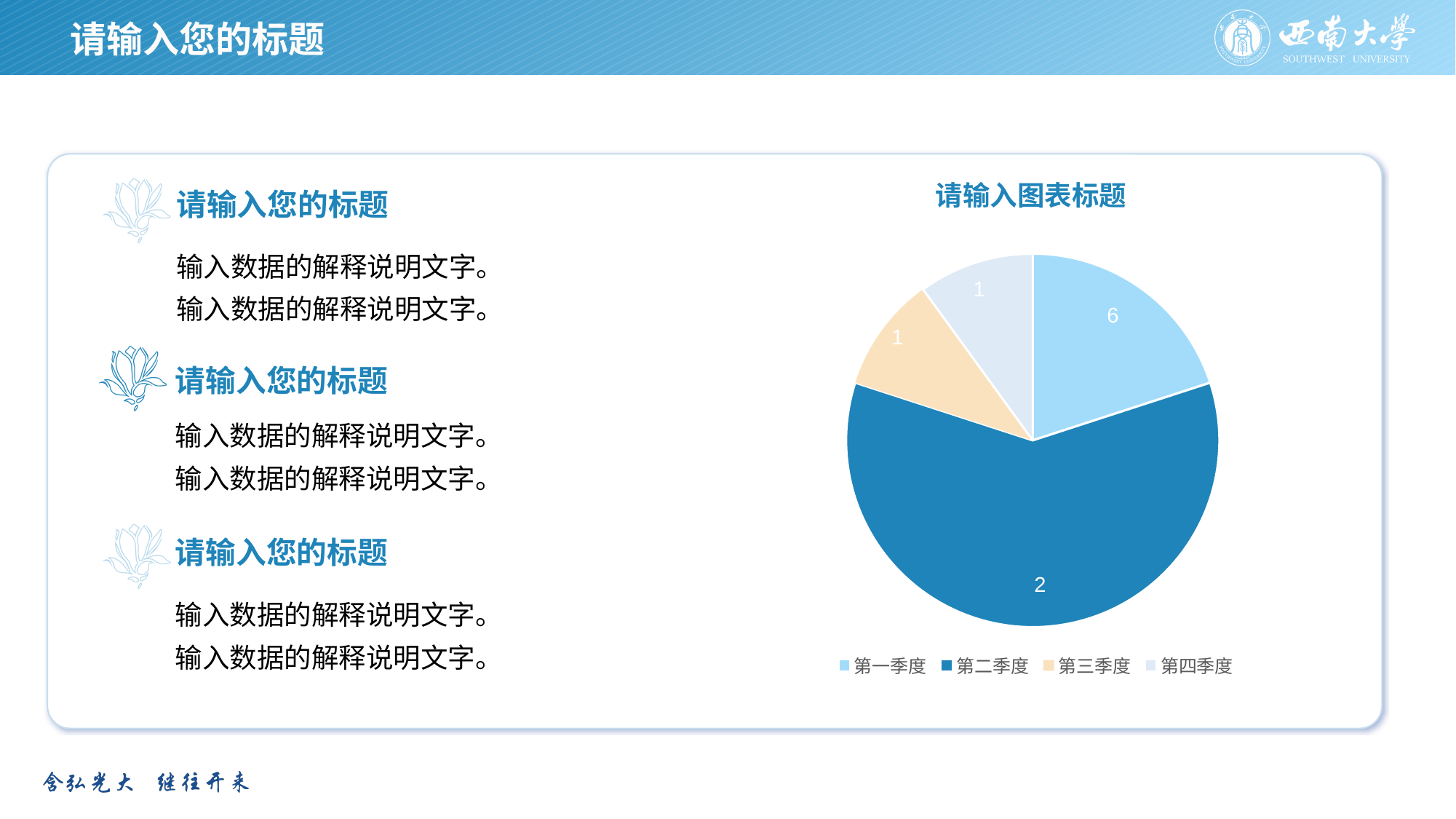
What kind of chart is shown on the slide? pie chart Which legend entry is listed first in the chart legend? 第一季度 What data label is printed on the 第一季度 slice? 6 What data label is printed on the 第三季度 slice? 1 What is the title of the chart? 请输入图表标题 How many slices does the pie chart have? 4 What data label is printed on the 第二季度 slice? 2 How many entries does the chart legend list? 4 Is the 第二季度 slice larger or smaller than the 第三季度 slice? larger What data label is printed on the 第四季度 slice? 1 Which slice takes up the largest area of the pie chart? 第二季度